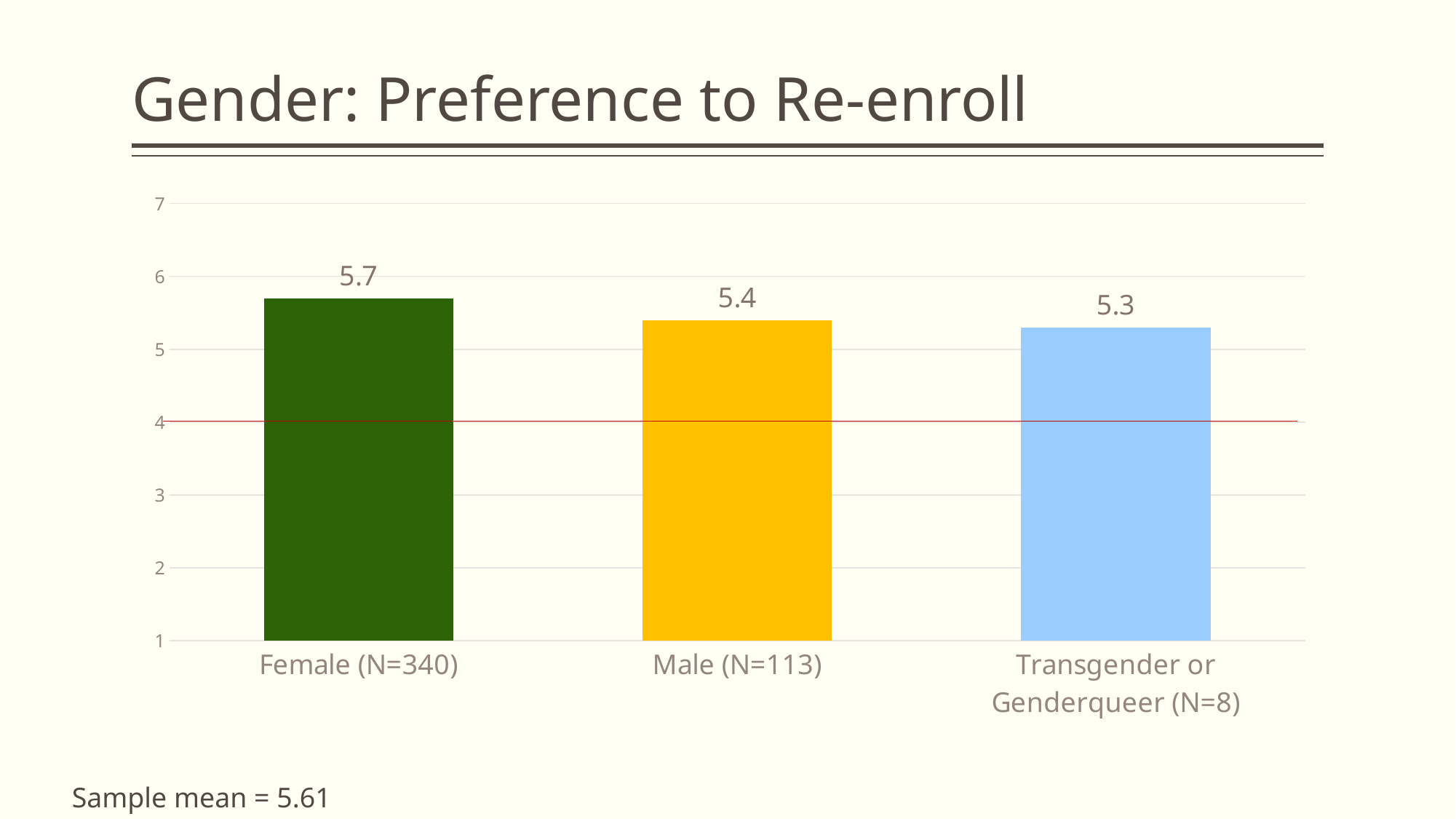
What is the difference between the values for Female (N=340) and Male (N=113)? 0.3 What is the value for Transgender or Genderqueer (N=8)? 5.3 What is the difference between the values for Female (N=340) and Transgender or Genderqueer (N=8)? 0.4 How many categories are shown in the chart? 3 Is the value for Male (N=113) greater or less than 4? greater Which category has the lowest value? Transgender or Genderqueer (N=8) Which is larger, the value for Female (N=340) or the value for Male (N=113)? Female (N=340) Which category has the highest value? Female (N=340) What is the title of the chart? Gender: Preference to Re-enroll What is the value for Male (N=113)? 5.4 What is the value for Female (N=340)? 5.7 What kind of chart is shown on the slide? Bar chart